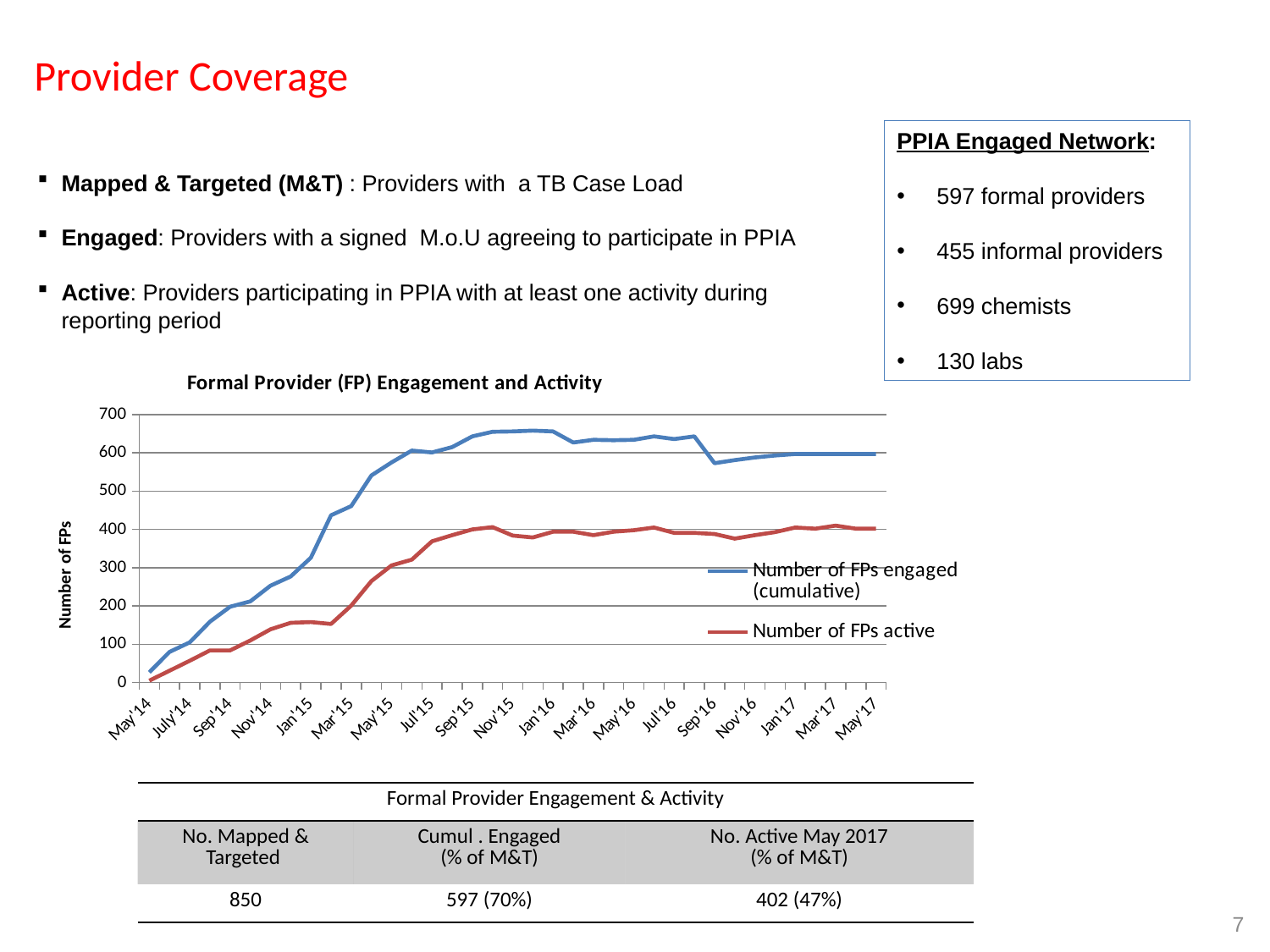
At May'16, which series has the larger value: Number of FPs engaged (cumulative) or Number of FPs active? Number of FPs engaged (cumulative) Is the value for Number of FPs active at May'17 greater or less than 300? greater What kind of chart is shown on the slide? line chart Is the value for Number of FPs engaged (cumulative) at May'17 greater or less than 500? greater What is the label on the chart's vertical axis? Number of FPs What is the title of the chart? Formal Provider (FP) Engagement and Activity Does the Number of FPs engaged (cumulative) line rise or fall overall from May'14 to May'17? rise Is the value for Number of FPs engaged (cumulative) at May'14 greater or less than 100? less How many series does the chart legend list? 2